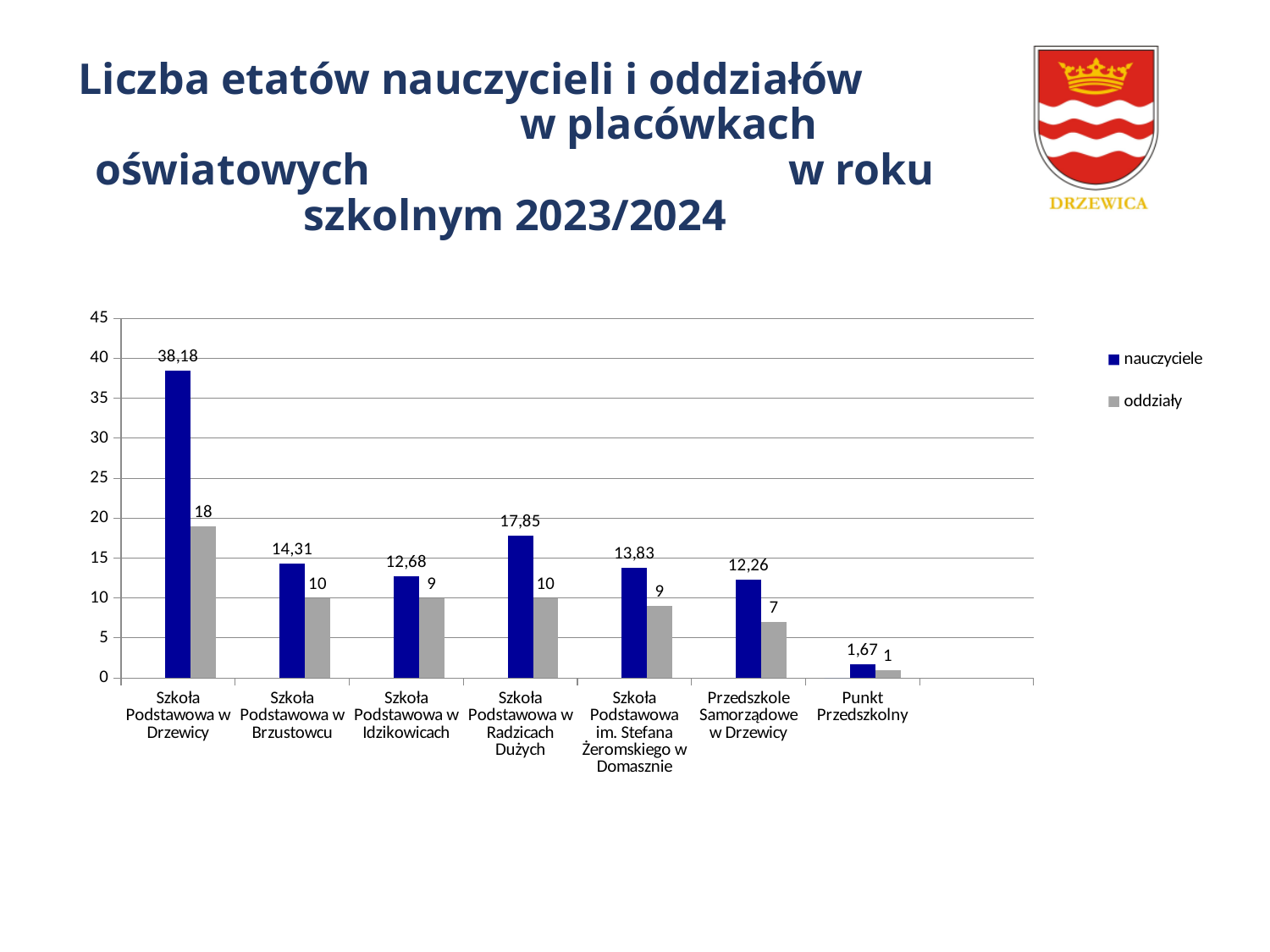
Which is larger: the nauczyciele value for Szkoła Podstawowa w Radzicach Dużych or for Szkoła Podstawowa im. Stefana Żeromskiego w Domasznie? Szkoła Podstawowa w Radzicach Dużych How many series does the legend list? 2 How many categories are shown on the x axis? 7 Which category has the lowest oddziały value? Punkt Przedszkolny What kind of chart is shown on the slide? bar chart What is the nauczyciele value for Szkoła Podstawowa w Drzewicy? 38,18 Is the nauczyciele value for Szkoła Podstawowa w Idzikowicach greater or less than 15? less What is the difference between the oddziały values for Szkoła Podstawowa w Drzewicy and Przedszkole Samorządowe w Drzewicy? 11 Which category has the highest nauczyciele value? Szkoła Podstawowa w Drzewicy What is the nauczyciele value for Przedszkole Samorządowe w Drzewicy? 12,26 What is the oddziały value for Szkoła Podstawowa w Brzustowcu? 10 Which series is shown in grey in the legend? oddziały